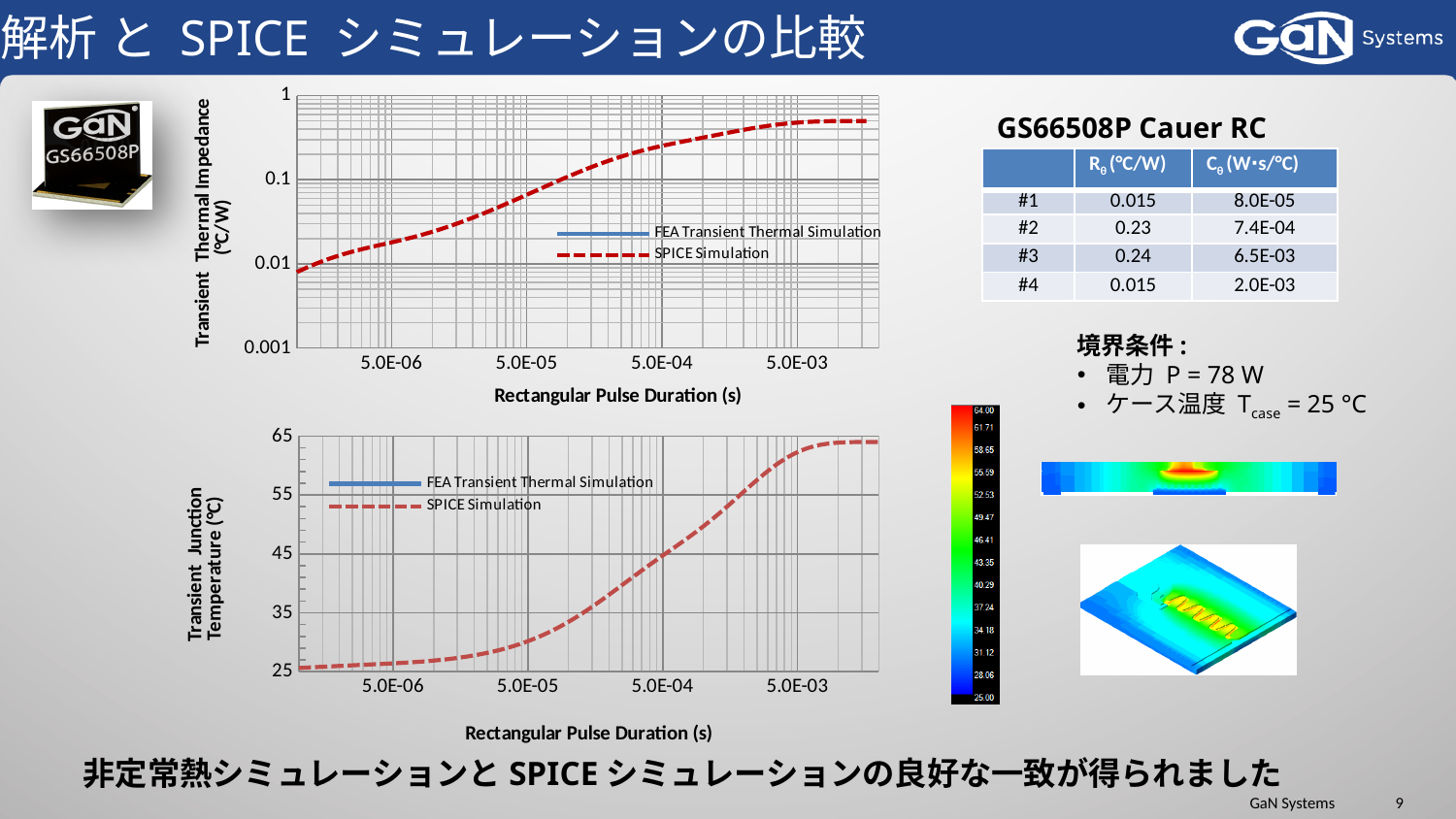
How many series does the legend of the top chart list? 2 What kind of chart is the bottom chart (Transient Junction Temperature vs Rectangular Pulse Duration)? line chart In the top chart, does the transient thermal impedance rise or fall as the rectangular pulse duration increases? rise In the top chart, which series is drawn as a dashed line? SPICE Simulation In the top chart, is the transient thermal impedance at a pulse duration of 5.0E-03 s greater or less than 0.1? greater In the bottom chart, does the transient junction temperature rise or fall as the rectangular pulse duration increases? rise In the top chart, is the transient thermal impedance at a pulse duration of 5.0E-06 s greater or less than 0.1? less In the bottom chart, is the transient junction temperature at a pulse duration of 5.0E-03 s greater or less than 55? greater What is the x-axis title of the bottom chart? Rectangular Pulse Duration (s) How many series does the legend of the bottom chart list? 2 What kind of chart is the top chart (Transient Thermal Impedance vs Rectangular Pulse Duration)? line chart